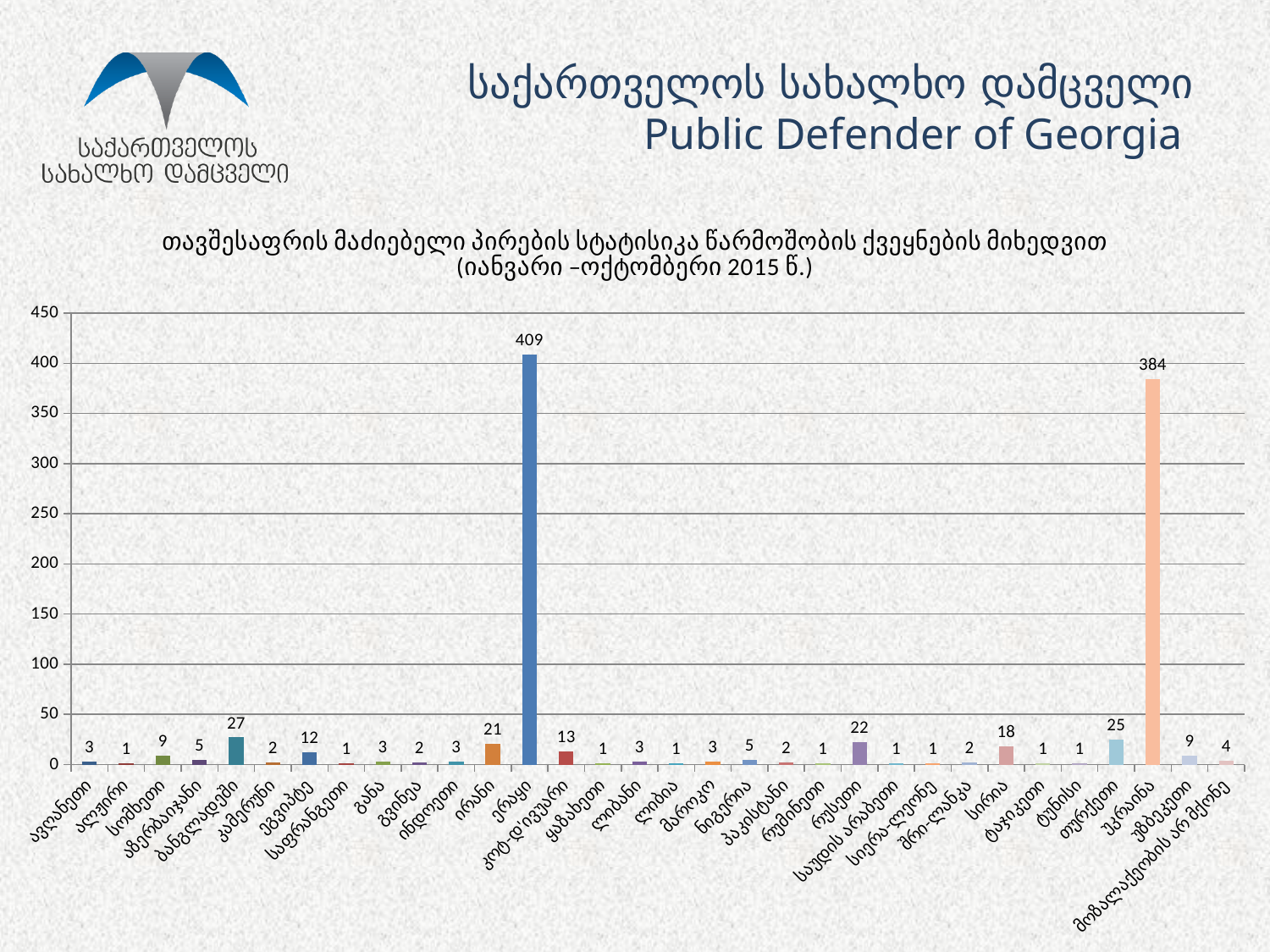
Is the value for ერაყი greater or less than 400? greater Which category has the highest value? ერაყი What is the value for ერაყი? 409 Which is larger, the value for ირანი or the value for სირია? ირანი What is the value for ბანგლადეში? 27 What is the difference between the values for ერაყი and უკრაინა? 25 What is the value for უკრაინა? 384 What is the value for თურქეთი? 25 What is the value for რუსეთი? 22 What period is given in parentheses in the chart title? იანვარი –ოქტომბერი 2015 წ. What kind of chart is shown on the slide? bar chart How many categories are shown on the x axis? 32